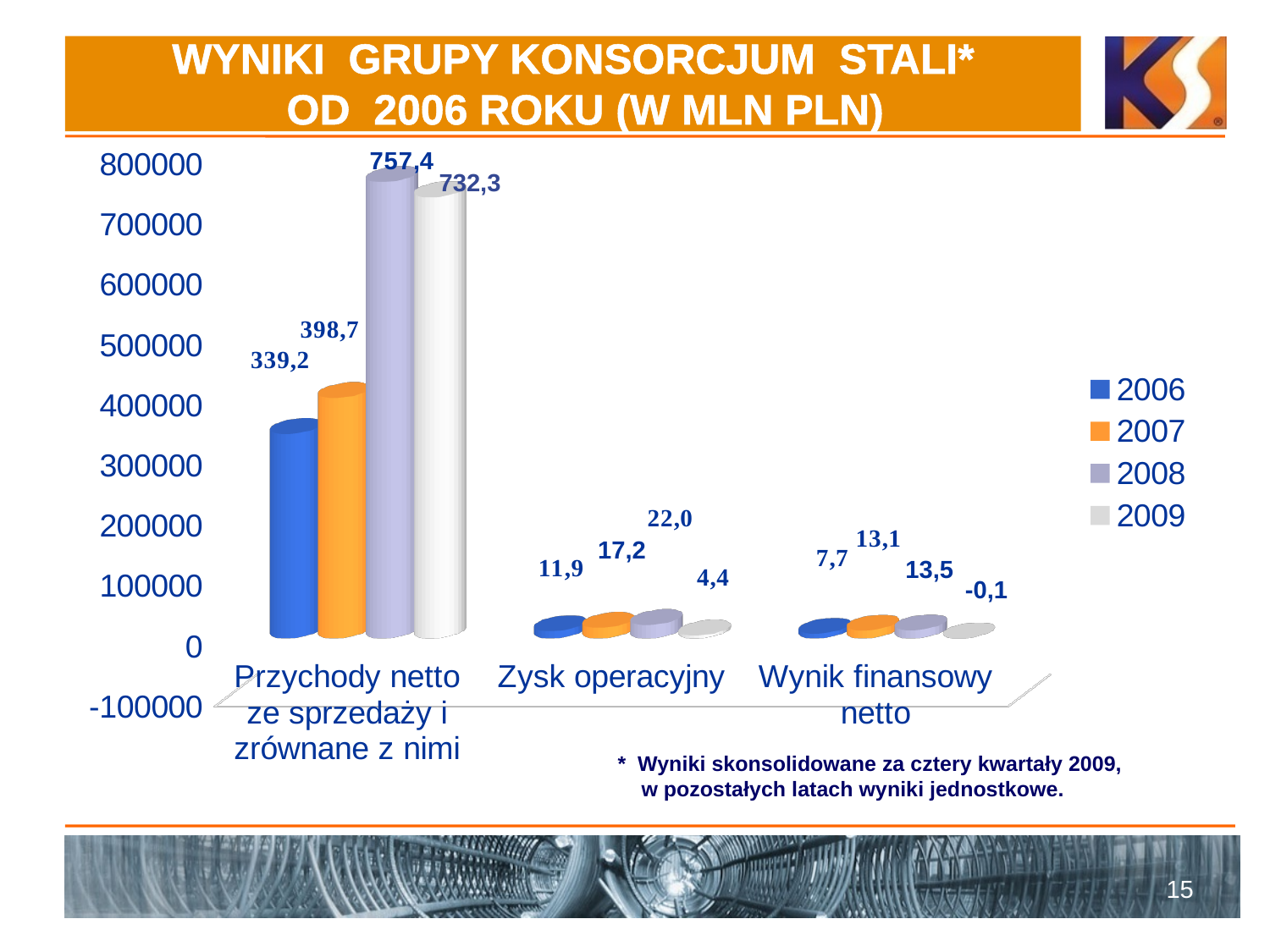
What is the value for 2008 in the Przychody netto ze sprzedaży i zrównane z nimi category? 757,4 What kind of chart is shown on the slide? Bar chart How many series does the legend list? 4 What is the difference between the 2008 and 2009 values in the Zysk operacyjny category? 17,6 In the Przychody netto ze sprzedaży i zrównane z nimi category, which is larger: the 2006 value or the 2007 value? 2007 What is the value for 2009 in the Wynik finansowy netto category? -0,1 What is the value for 2006 in the Wynik finansowy netto category? 7,7 How many categories are shown on the x axis? 3 What is the value for 2009 in the Zysk operacyjny category? 4,4 What is the difference between the 2008 and 2009 values in the Przychody netto ze sprzedaży i zrównane z nimi category? 25,1 Which year has the highest value in the Przychody netto ze sprzedaży i zrównane z nimi category? 2008 Which year has the lowest value in the Zysk operacyjny category? 2009